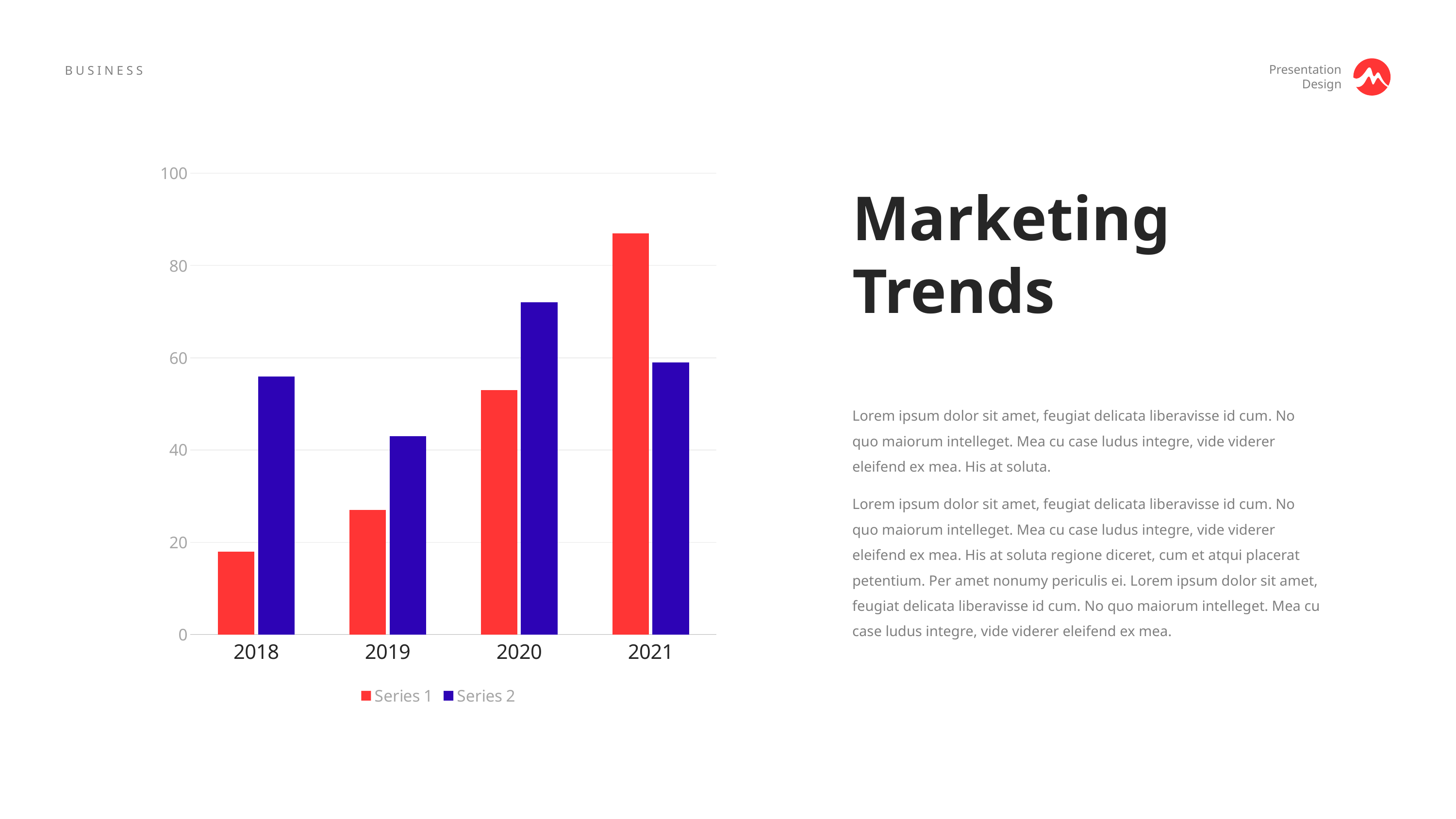
What kind of chart is shown on the slide? bar chart How many series does the legend list? 2 Which year has the lowest value for Series 2? 2019 Do the values for Series 1 rise or fall from 2018 to 2021? rise How many categories are shown on the x axis? 4 Which year has the highest value for Series 2? 2020 Which year has the lowest value for Series 1? 2018 Is the value for Series 1 in 2021 greater or less than 80? greater Is the value for Series 1 in 2018 greater or less than 20? less Which year has the highest value for Series 1? 2021 In 2019, which series has the larger value, Series 1 or Series 2? Series 2 Is the value for Series 2 in 2020 greater or less than 60? greater